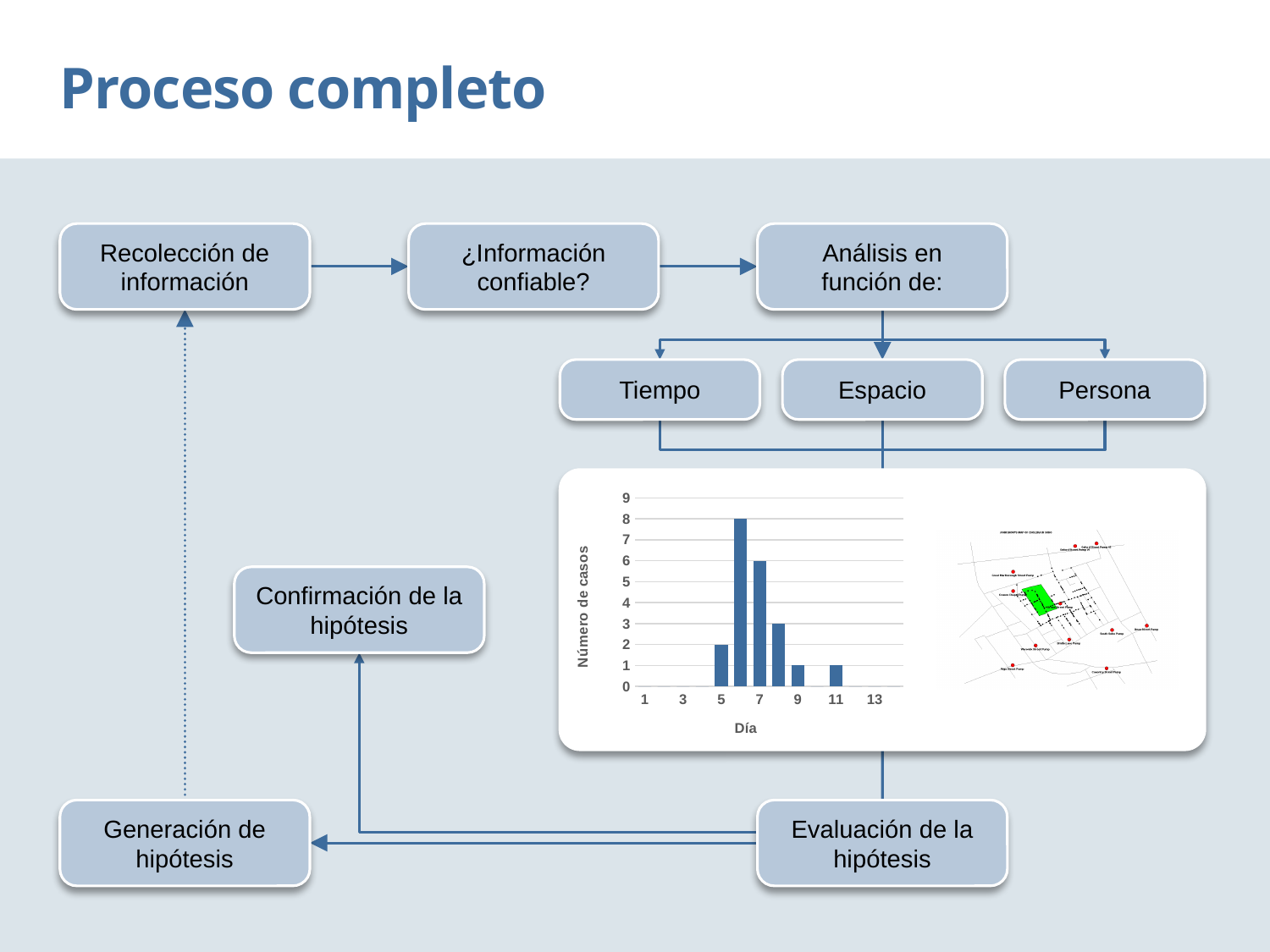
In the bar chart, what is the title of the horizontal axis? Día In the bar chart, what is the number of cases on day 5? 2 In the bar chart, do the values rise or fall from day 7 to day 9? fall In the bar chart, how many bars are plotted? 6 What kind of chart is shown in the white panel on the slide? bar chart In the bar chart, what is the difference in cases between day 7 and day 5? 4 In the bar chart, which has more cases, day 5 or day 7? day 7 In the bar chart, what is the title of the vertical axis? Número de casos In the bar chart, what is the number of cases on day 7? 6 In the bar chart, what is the highest number of cases reached by any bar? 8 In the bar chart, what is the number of cases on day 9? 1 In the bar chart, what is the number of cases on day 11? 1